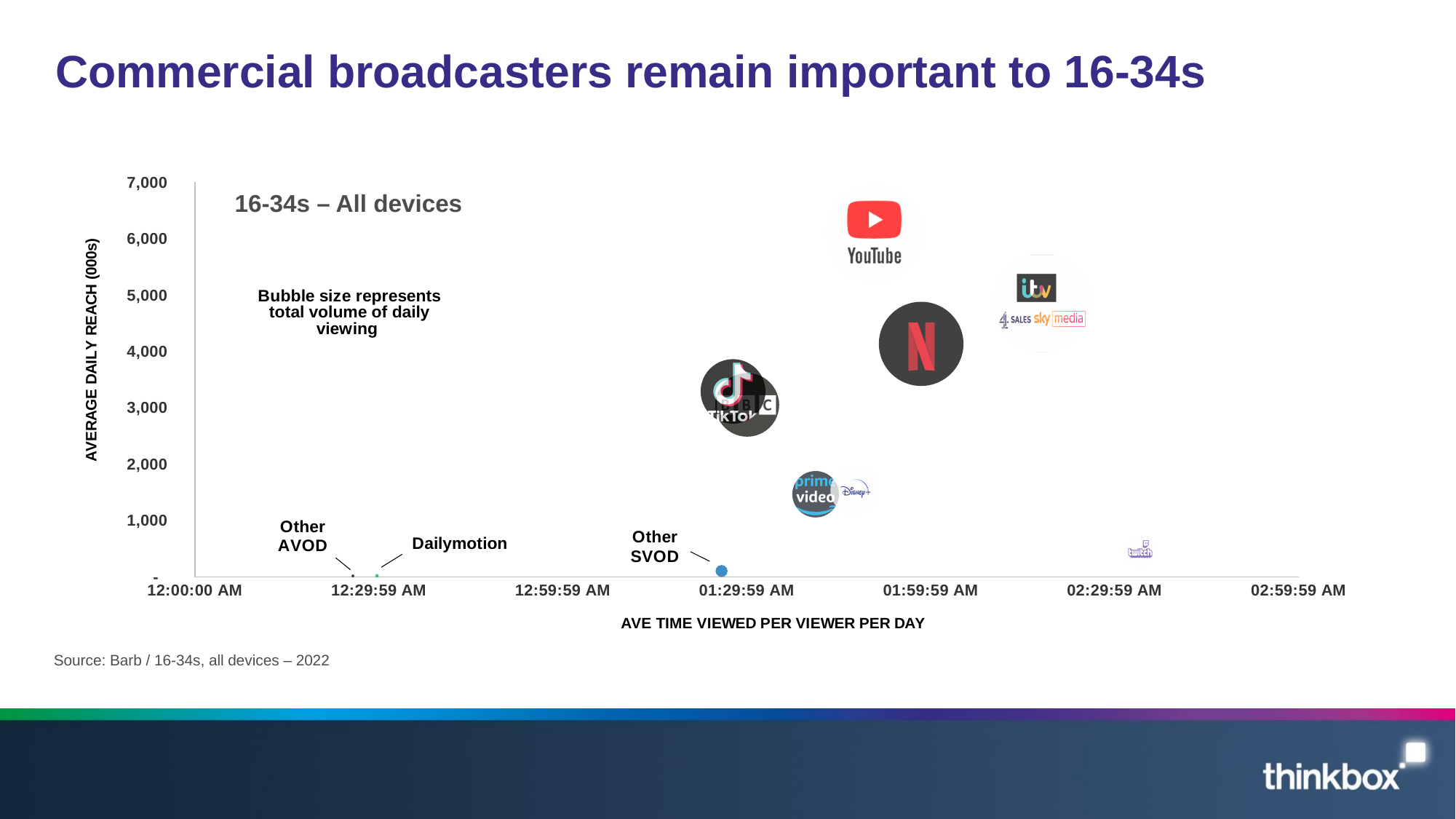
Which platform has the longest average time viewed per viewer per day? Twitch Which has the higher average daily reach, YouTube or Netflix? YouTube Which platform has the shortest average time viewed per viewer per day? Other AVOD Which platform has the highest average daily reach? YouTube Is the average daily reach for Twitch greater or less than 1,000? less What is the title of the vertical axis? AVERAGE DAILY REACH (000s) Is the average daily reach for Prime Video greater or less than 2,000? less Is the average daily reach for YouTube greater or less than 5,000? greater What does the bubble size represent in the chart? Total volume of daily viewing Which has the longer average time viewed per viewer per day, Netflix or TikTok? Netflix What kind of chart is shown on the slide? Bubble chart